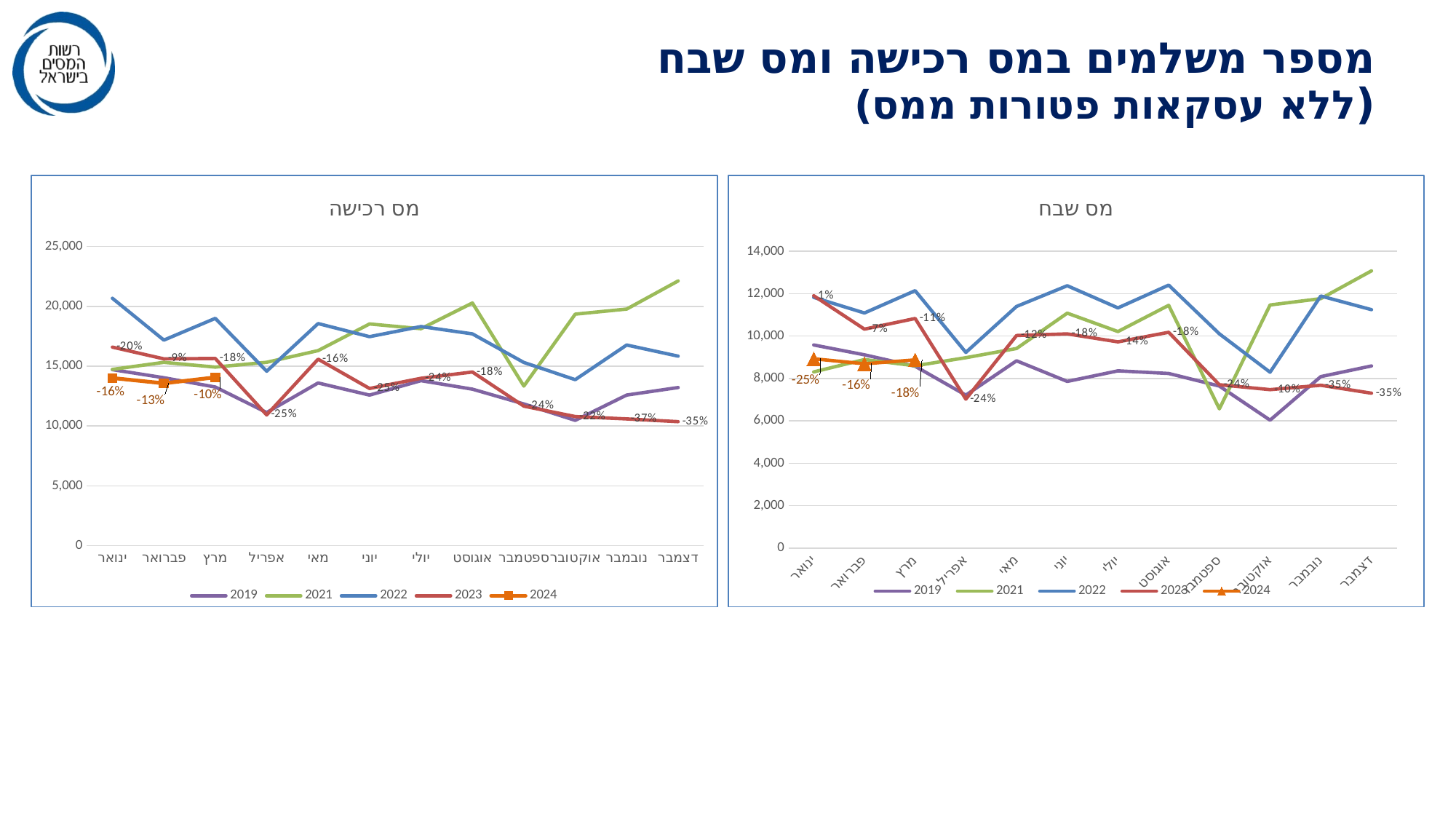
On the מס שבח chart, what percentage label is shown for the 2024 series in מרץ? -18% What kind of chart is the מס רכישה chart on the left? line chart On the מס רכישה chart, what percentage label is shown for the 2024 series in מרץ? -10% On the מס רכישה chart, what percentage label is shown for the 2024 series in פברואר? -13% How many months are shown on the x axis of the מס רכישה chart? 12 On the מס רכישה chart, is the value for 2022 in ינואר greater or less than 20,000? greater On the מס שבח chart, is the value for 2021 in דצמבר greater or less than 12,000? greater How many series does the legend of the מס שבח chart list? 5 On the מס רכישה chart, which is larger in ינואר: the 2022 series or the 2019 series? 2022 On the מס שבח chart, what percentage label is shown for the 2024 series in ינואר? -25% On the מס שבח chart, does the 2023 series rise or fall from אוגוסט to דצמבר? fall On the מס רכישה chart, which series has the highest value in דצמבר? 2021